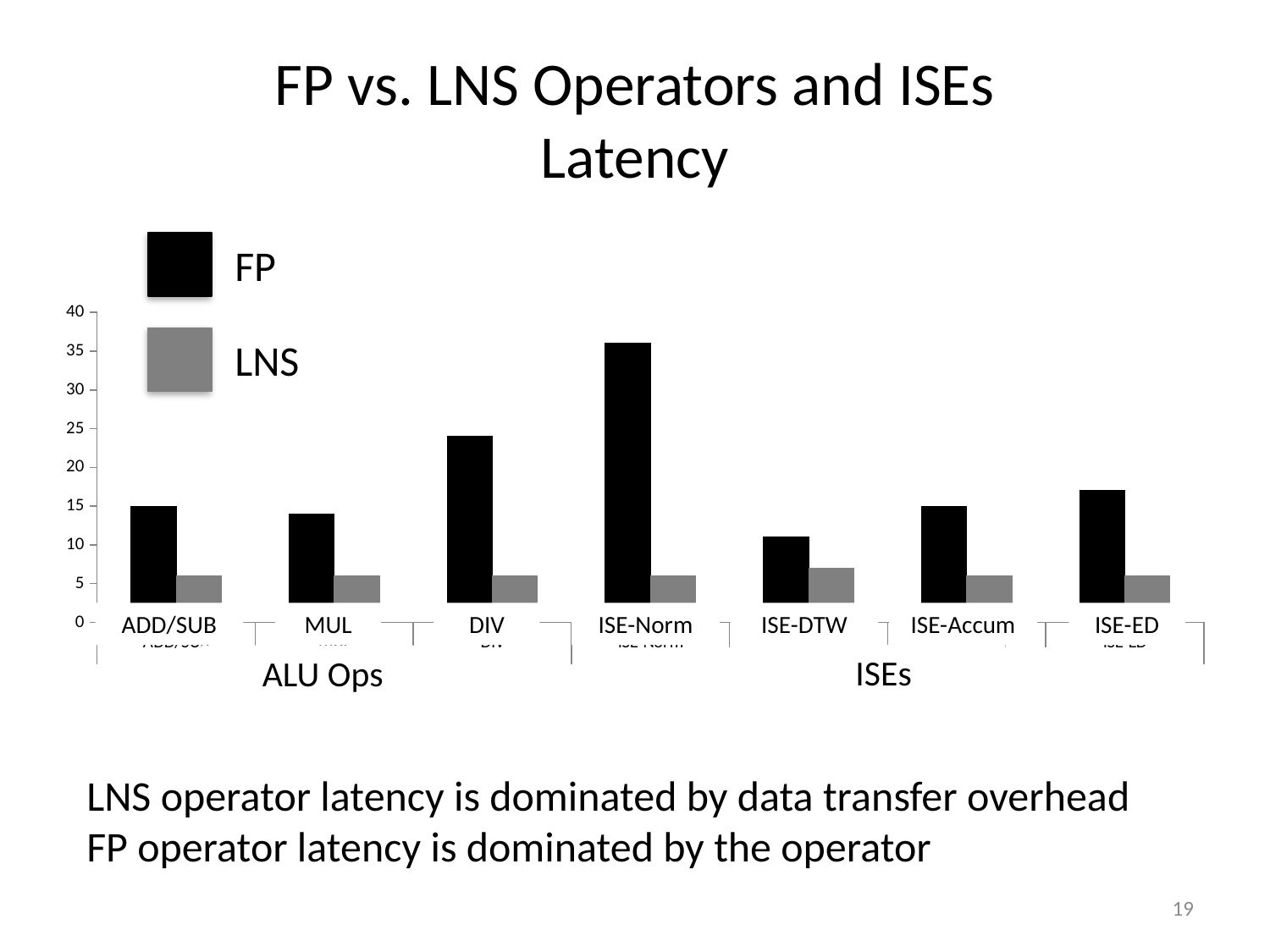
How many operator categories are plotted along the x axis? 7 Which category has the lowest FP latency? ISE-DTW Which has the larger FP latency, ISE-Norm or ISE-ED? ISE-Norm How many series does the legend list? 2 Which has the larger FP latency, DIV or MUL? DIV What kind of chart is shown on the slide? bar chart Is the FP latency for ISE-Norm greater or less than 30? greater Which category has the highest FP latency? ISE-Norm Is the FP latency for DIV greater or less than 20? greater Is the LNS latency for ISE-Norm greater or less than 10? less Which two groups are the categories divided into beneath the x axis? ALU Ops and ISEs